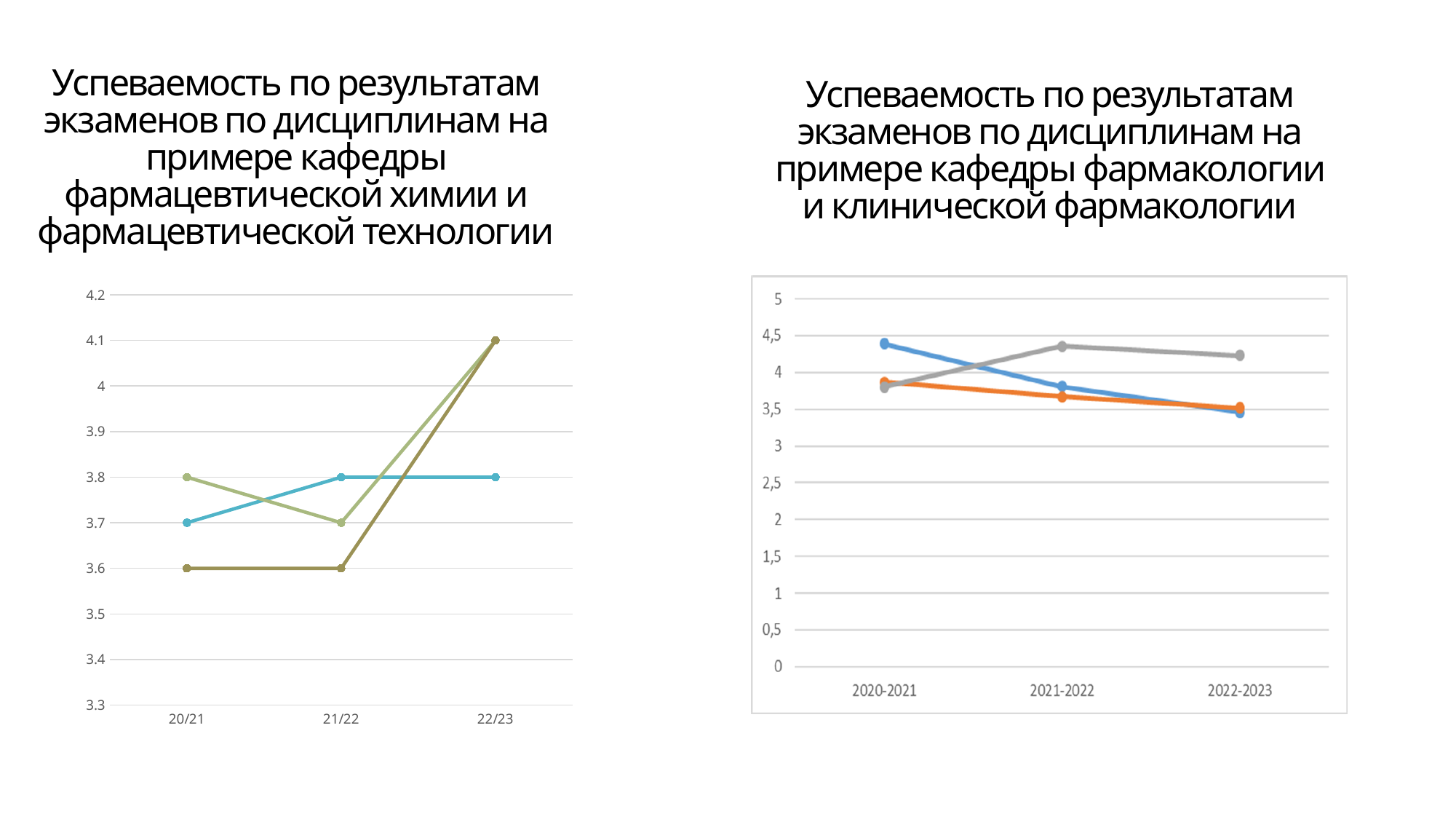
In the left chart, does the dark olive line rise or fall from 21/22 to 22/23? Rise In the left chart, what is the difference between the light green line's value at 22/23 and its value at 21/22? 0.4 In the right chart, is the value of the blue line at 2020-2021 greater or less than 4? greater In the right chart, is the value of the orange line at 2022-2023 greater or less than 4? less How many points are on the x axis of the left chart? 3 In the left chart, what is the value of the light green line at 22/23? 4.1 In the right chart, does the blue line rise or fall from 2020-2021 to 2022-2023? Fall In the left chart, what is the value of the dark olive line at 21/22? 3.6 How many categories are on the x axis of the right chart (pharmacology and clinical pharmacology)? 3 What type of chart is the left chart (pharmaceutical chemistry and technology)? Line chart In the left chart, what is the value of the blue line at 22/23? 3.8 In the left chart, what is the value of the blue line at 20/21? 3.7